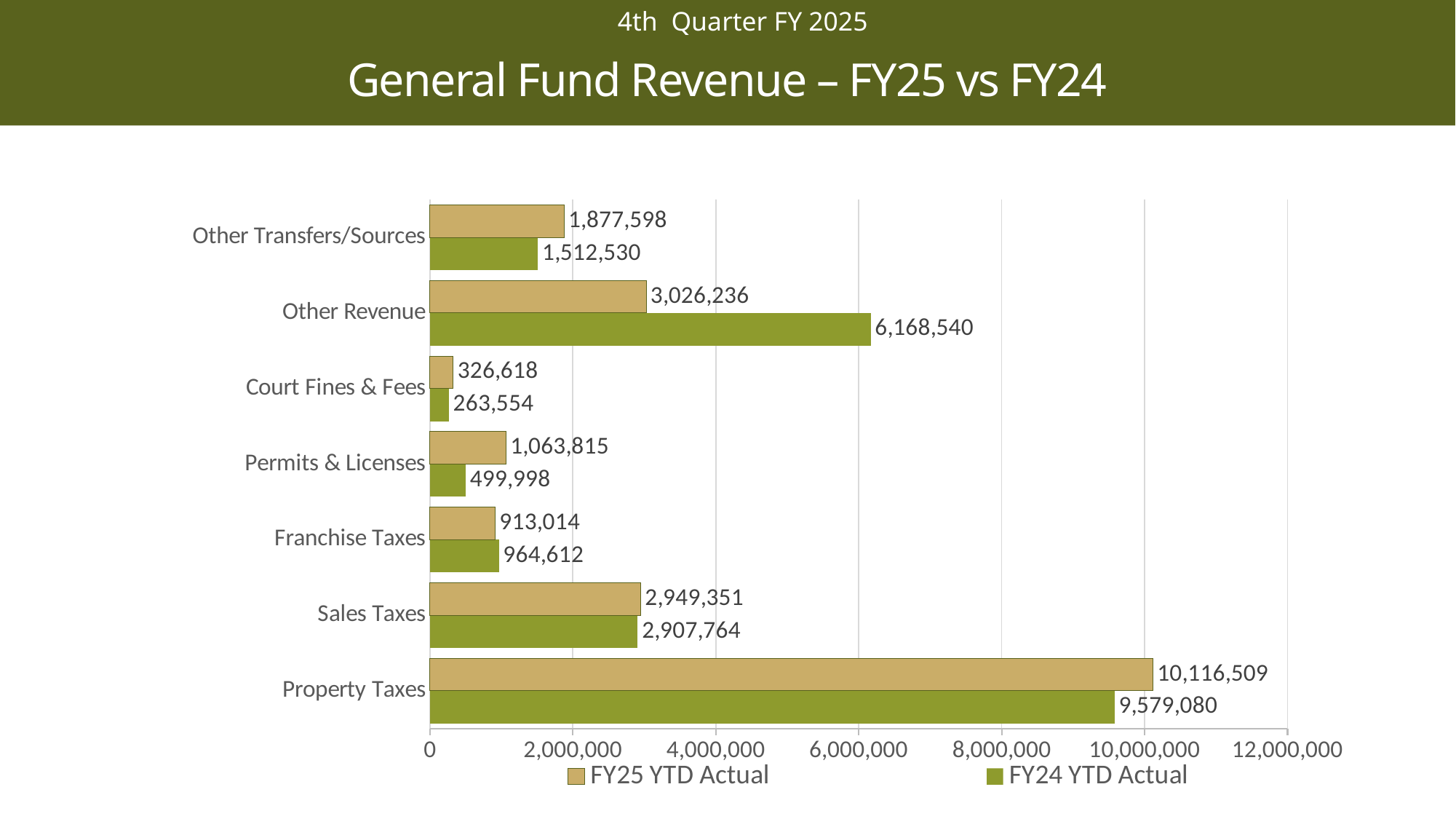
What is the FY24 YTD Actual value for Other Revenue? 6,168,540 How many revenue categories are shown on the chart? 7 How many series does the legend list? 2 What is the FY25 YTD Actual value for Property Taxes? 10,116,509 For Other Revenue, which is larger: the FY25 YTD Actual or the FY24 YTD Actual? FY24 YTD Actual Which category has the highest FY25 YTD Actual value? Property Taxes What type of chart is shown on the slide? Bar chart What is the difference between the FY25 YTD Actual and FY24 YTD Actual values for Property Taxes? 537,429 What is the difference between the FY24 YTD Actual and FY25 YTD Actual values for Other Revenue? 3,142,304 Which category has the lowest FY24 YTD Actual value? Court Fines & Fees What is the FY24 YTD Actual value for Permits & Licenses? 499,998 What is the FY25 YTD Actual value for Court Fines & Fees? 326,618